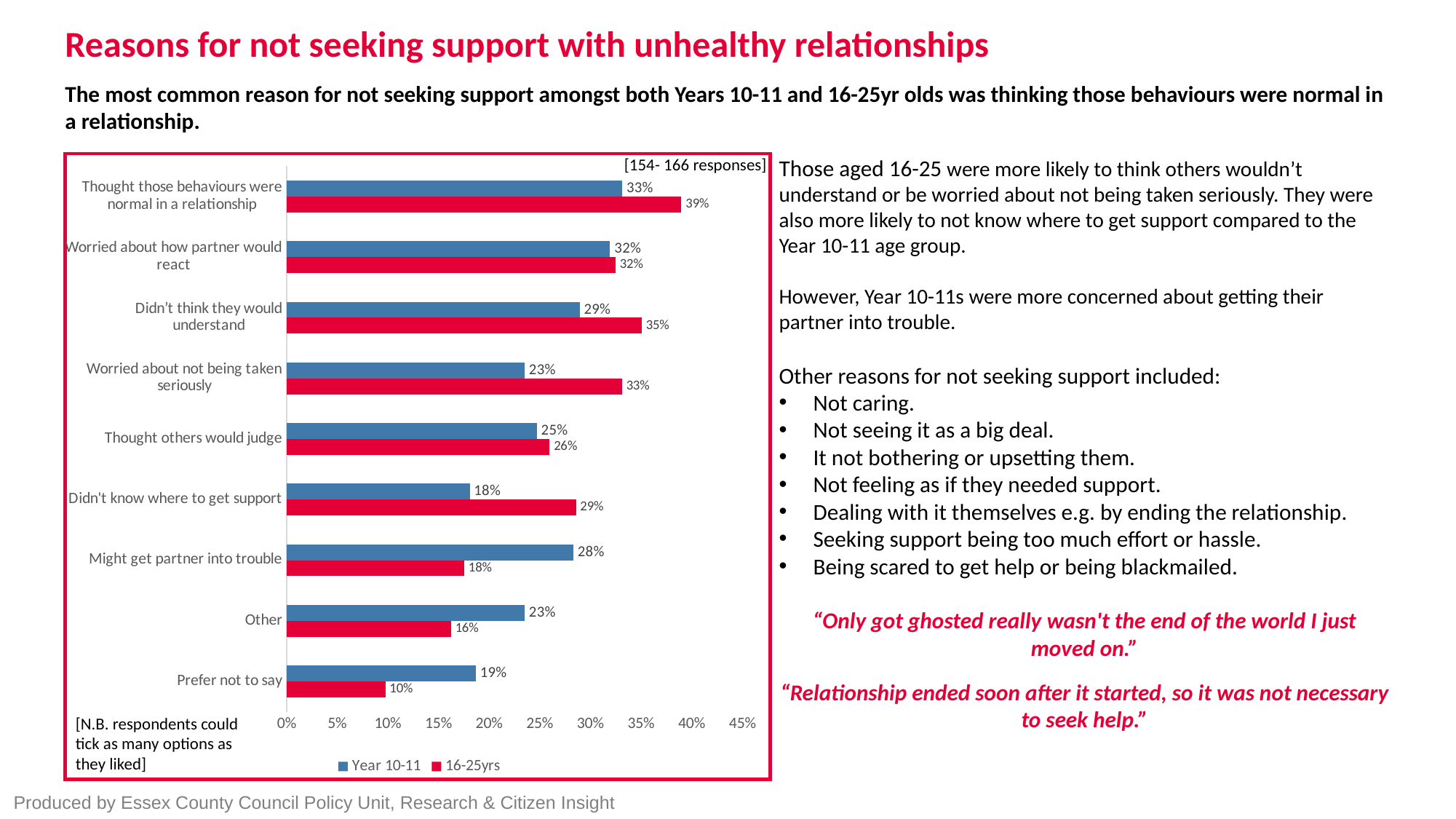
What kind of chart is shown on the slide? Bar chart For 'Might get partner into trouble', which series has the larger value, Year 10-11 or 16-25yrs? Year 10-11 What is the difference between the Year 10-11 and 16-25yrs values for 'Other'? 7% How many reasons (categories) are shown on the chart? 9 How many series does the chart legend list? 2 What is the difference between the 16-25yrs and Year 10-11 values for 'Worried about not being taken seriously'? 10% What colour represents the 16-25yrs series in the chart? Red What is the value for 'Prefer not to say' in the 16-25yrs series? 10% What percentage of Year 10-11 respondents thought those behaviours were normal in a relationship? 33% What percentage of 16-25yrs respondents didn't know where to get support? 29% Which reason has the lowest value for the Year 10-11 series? Didn't know where to get support Which reason has the highest value for the 16-25yrs series? Thought those behaviours were normal in a relationship